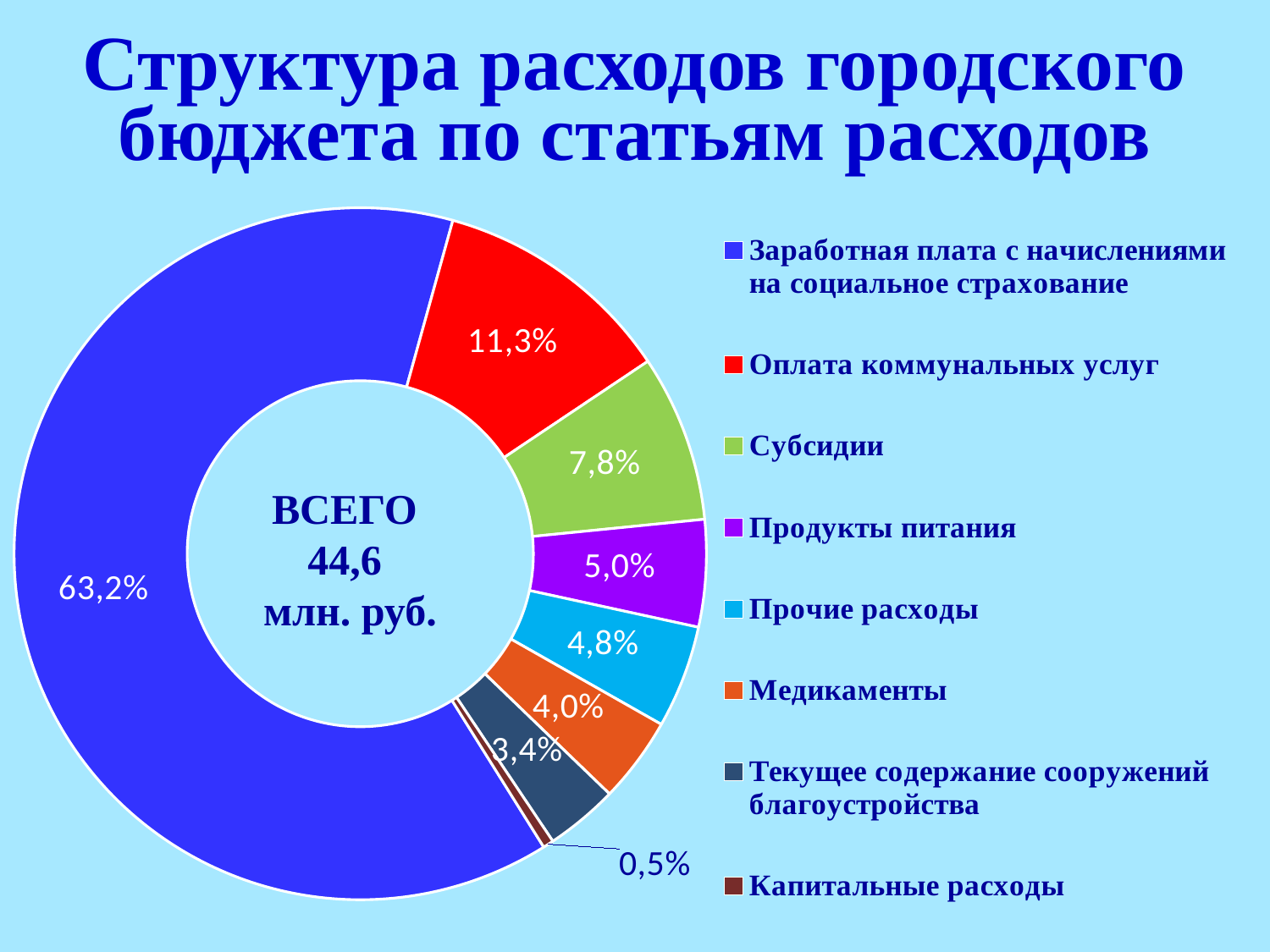
Which expense item has the smallest share of the budget? Капитальные расходы What percentage is shown for «Капитальные расходы»? 0,5% What percentage is shown for «Оплата коммунальных услуг»? 11,3% Which expense item has the largest share of the budget? Заработная плата с начислениями на социальное страхование What kind of chart is shown on the slide? Doughnut (pie) chart What is the value for «Субсидии»? 7,8% Which is larger: the share for «Продукты питания» or for «Прочие расходы»? Продукты питания What share is labelled for «Медикаменты»? 4,0% What is the difference in percentage points between «Оплата коммунальных услуг» and «Субсидии»? 3,5 How many expense items does the legend list? 8 What total amount is written in the centre of the chart? ВСЕГО 44,6 млн. руб. What share of the city budget expenses goes to «Заработная плата с начислениями на социальное страхование»? 63,2%